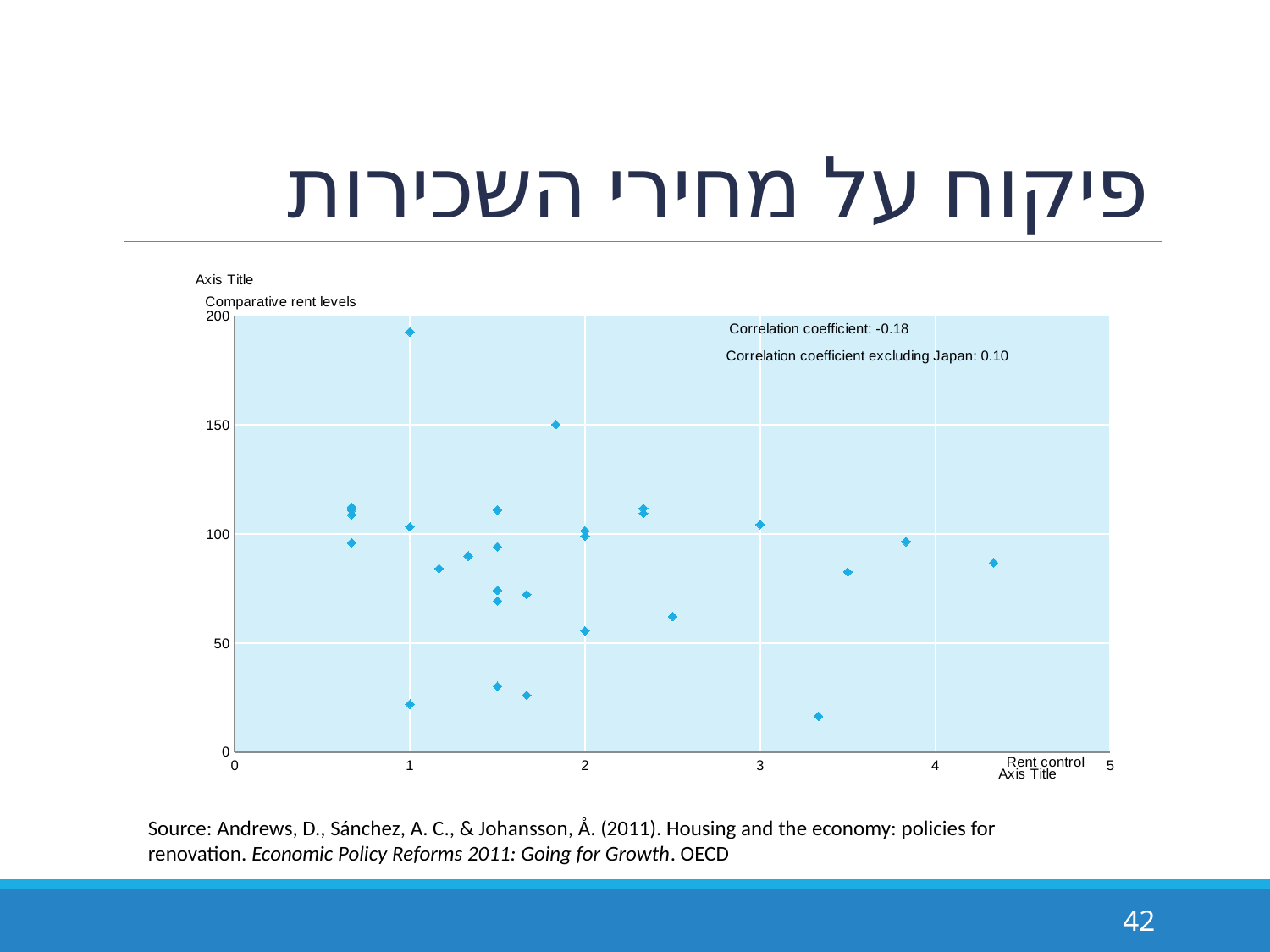
Is the comparative rent level of the highest point on the chart greater or less than 150? greater Is the comparative rent level of the lowest point on the chart greater or less than 50? less What is the highest tick value shown on the horizontal axis? 5 What correlation coefficient is printed on the chart when Japan is excluded? 0.10 What is the label of the vertical axis of the chart? Comparative rent levels What is the highest tick value shown on the vertical axis? 200 Is the rent control value of the rightmost point on the chart greater or less than 4? greater What correlation coefficient is printed on the chart for all points? -0.18 According to the correlation coefficient printed on the chart, is the overall relationship between rent control and comparative rent levels positive or negative? negative What kind of chart is shown on the slide? scatter chart What is the label of the horizontal axis of the chart? Rent control